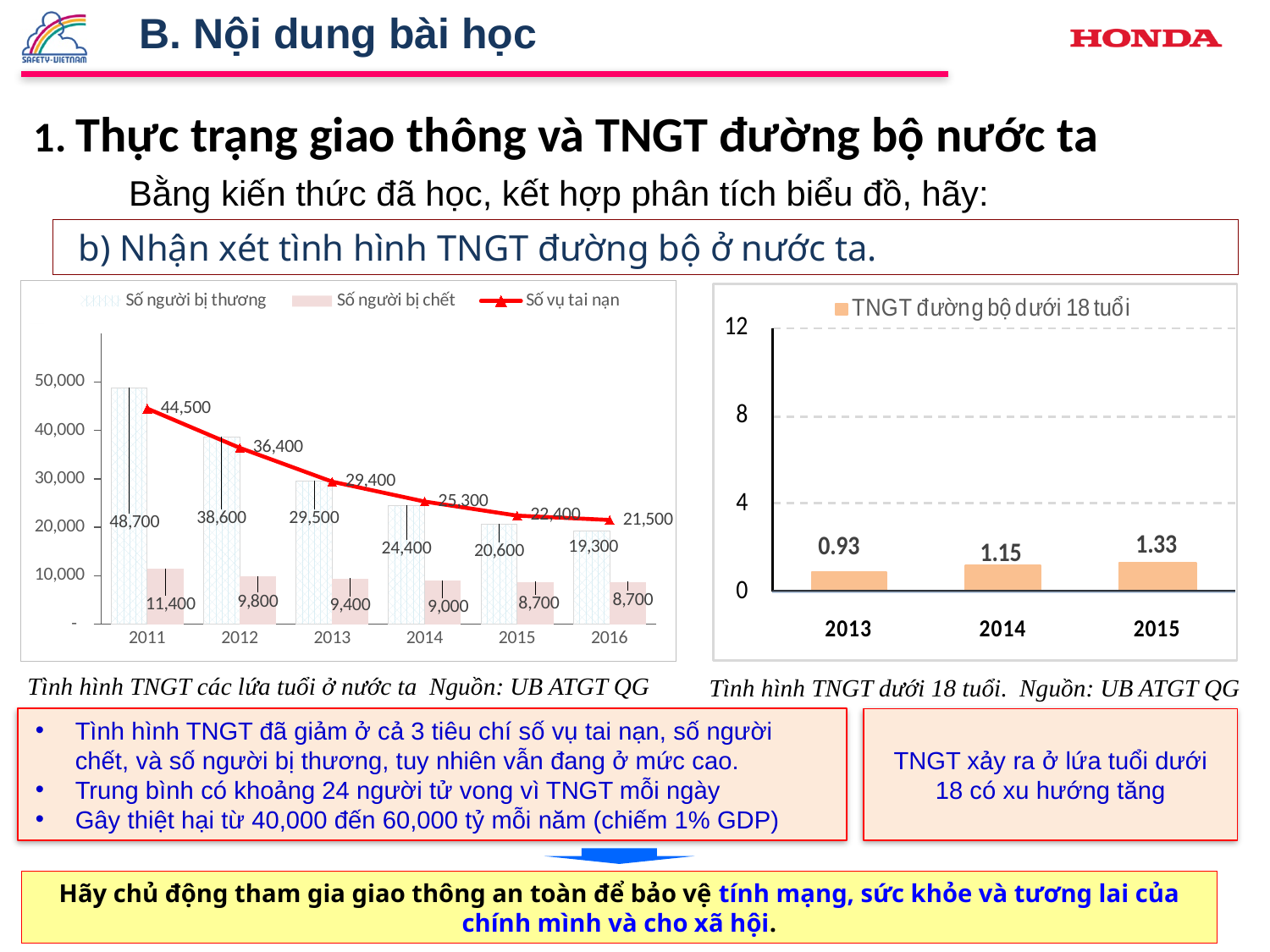
What kind of chart is the chart titled 'TNGT đường bộ dưới 18 tuổi'? bar chart In the chart titled 'TNGT đường bộ dưới 18 tuổi', what is the value for 2014? 1.15 In the chart titled 'TNGT đường bộ dưới 18 tuổi', do the values rise or fall from 2013 to 2015? rise In the left chart, what is the value of Số người bị thương in 2014? 24,400 In the left chart, what is the difference between Số vụ tai nạn in 2011 and in 2016? 23,000 In the left chart, what is the value of Số người bị chết in 2012? 9,800 In the left chart, which year has the highest value for Số người bị thương? 2011 In the left chart, how many series does the legend list? 3 In the left chart, what is the value of Số vụ tai nạn in 2011? 44,500 In the chart titled 'TNGT đường bộ dưới 18 tuổi', which year has the lowest value? 2013 In the left chart, does Số vụ tai nạn rise or fall from 2011 to 2016? fall In the left chart, how many years are shown on the x axis? 6